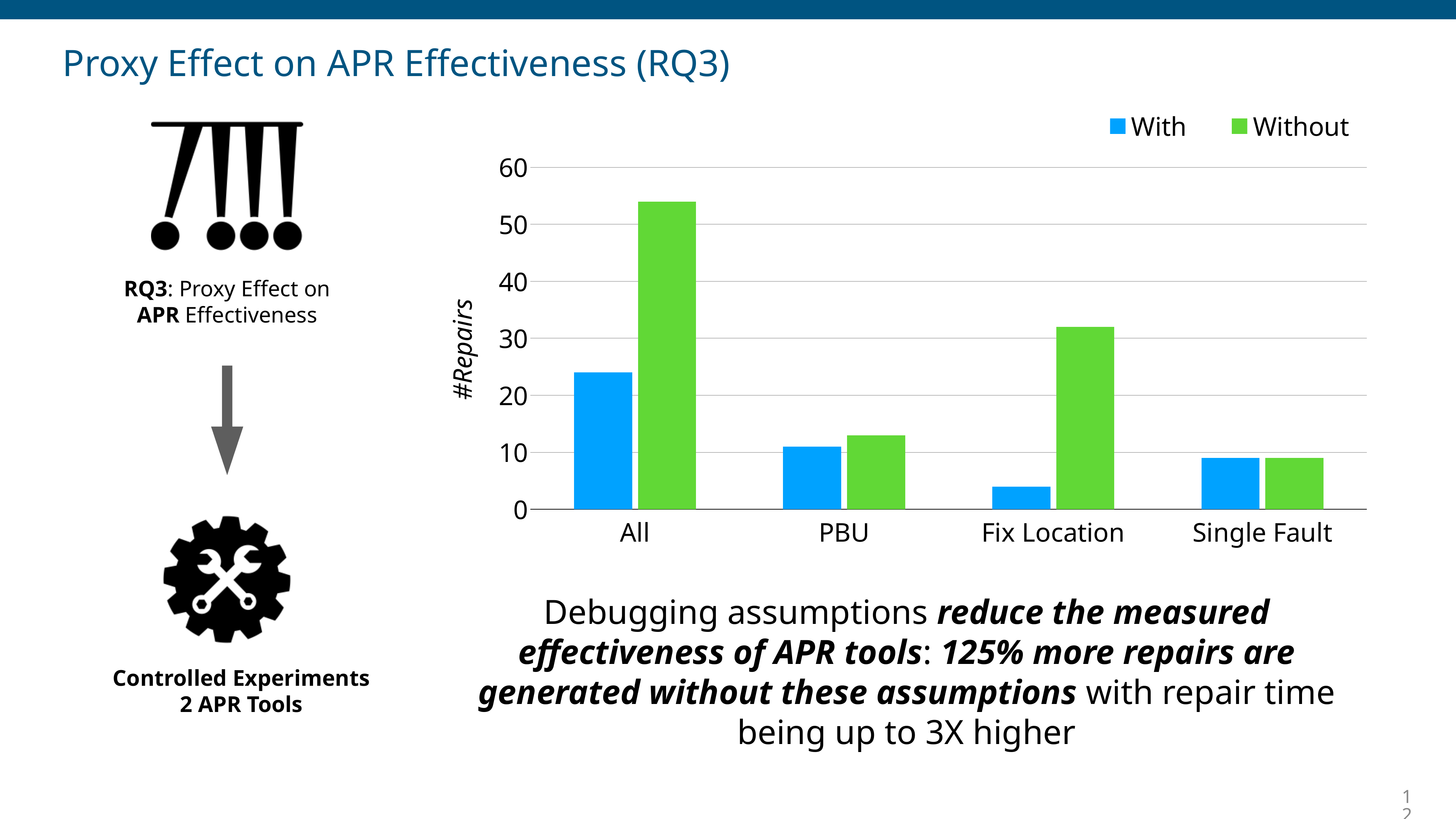
Is the 'Without' value for All greater or less than 50? greater Is the 'Without' value for Fix Location greater or less than 30? greater Which category has the highest 'Without' bar? All Which category has the lowest 'With' bar? Fix Location How many series does the chart legend list? 2 What kind of chart is shown on the slide? bar chart What is the label of the y axis of the chart? #Repairs How many categories are shown on the x axis of the chart? 4 For All, which is larger: the 'With' value or the 'Without' value? Without For Fix Location, which is larger: the 'With' value or the 'Without' value? Without Is the 'With' value for Fix Location greater or less than 10? less